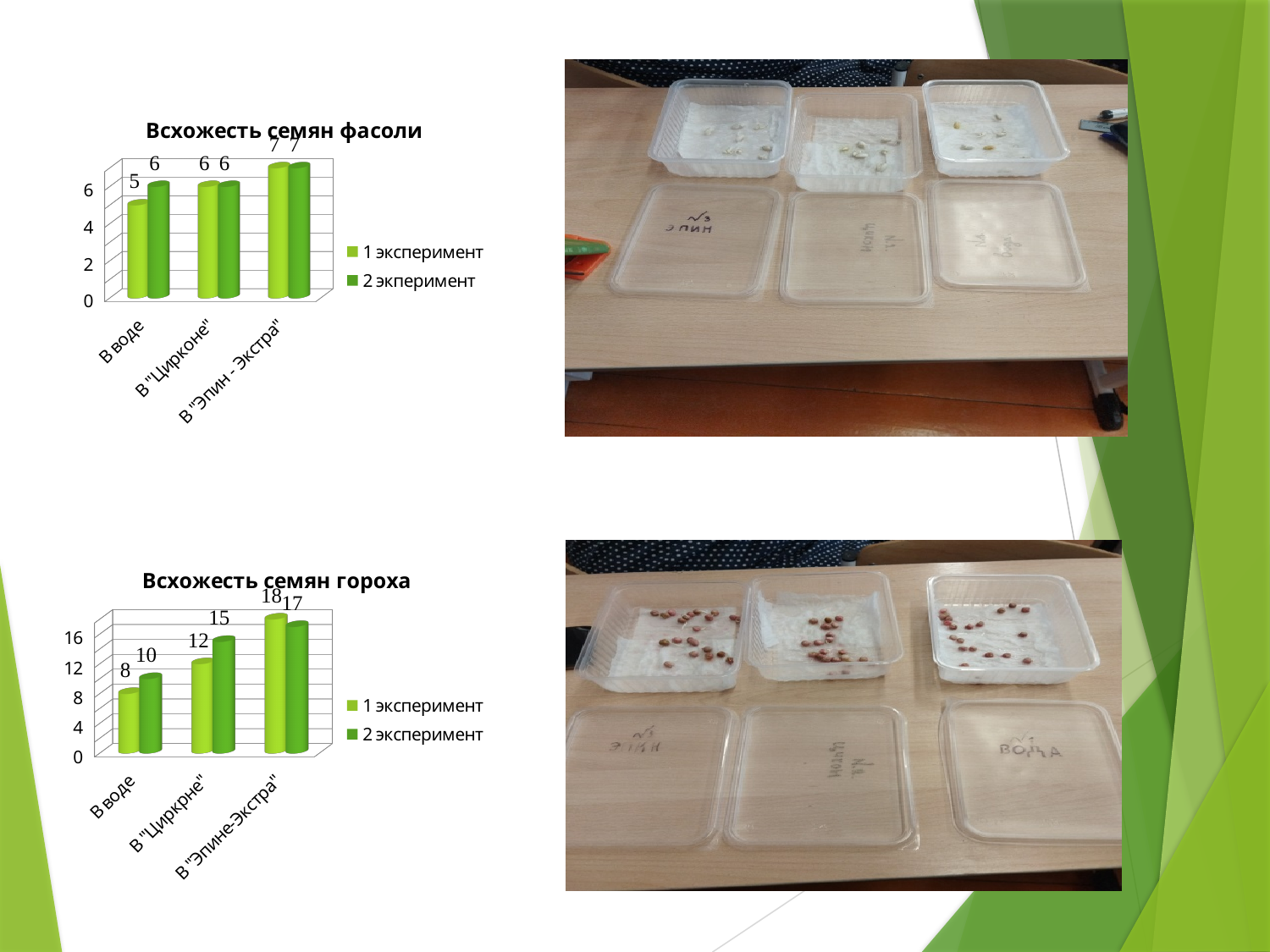
In the chart titled "Всхожесть семян фасоли", how many series does the legend list? 2 In the chart titled "Всхожесть семян гороха", what is the value for "В воде" in the "2 эксперимент" series? 10 In the chart titled "Всхожесть семян гороха", which is larger for "В "Эпине-Экстра"": the "1 эксперимент" value or the "2 эксперимент" value? 1 эксперимент In the chart titled "Всхожесть семян гороха", what is the difference between the "1 эксперимент" and "2 эксперимент" values for "В "Циркрне""? 3 In the chart titled "Всхожесть семян фасоли", what is the value for "В "Эпин - Экстра"" in the "2 эксперимент" series? 7 In the chart titled "Всхожесть семян гороха", do the "1 эксперимент" values rise or fall from left to right along the x axis? Rise In the chart titled "Всхожесть семян фасоли", which category has the highest value in the "1 эксперимент" series? В "Эпин - Экстра" In the chart titled "Всхожесть семян фасоли", what is the value for "В воде" in the "1 эксперимент" series? 5 In the chart titled "Всхожесть семян гороха", how many categories are shown on the x axis? 3 What kind of chart is the chart titled "Всхожесть семян гороха"? Bar chart In the chart titled "Всхожесть семян гороха", which category has the lowest value in the "1 эксперимент" series? В воде In the chart titled "Всхожесть семян гороха", what is the value for "В "Циркрне"" in the "1 эксперимент" series? 12